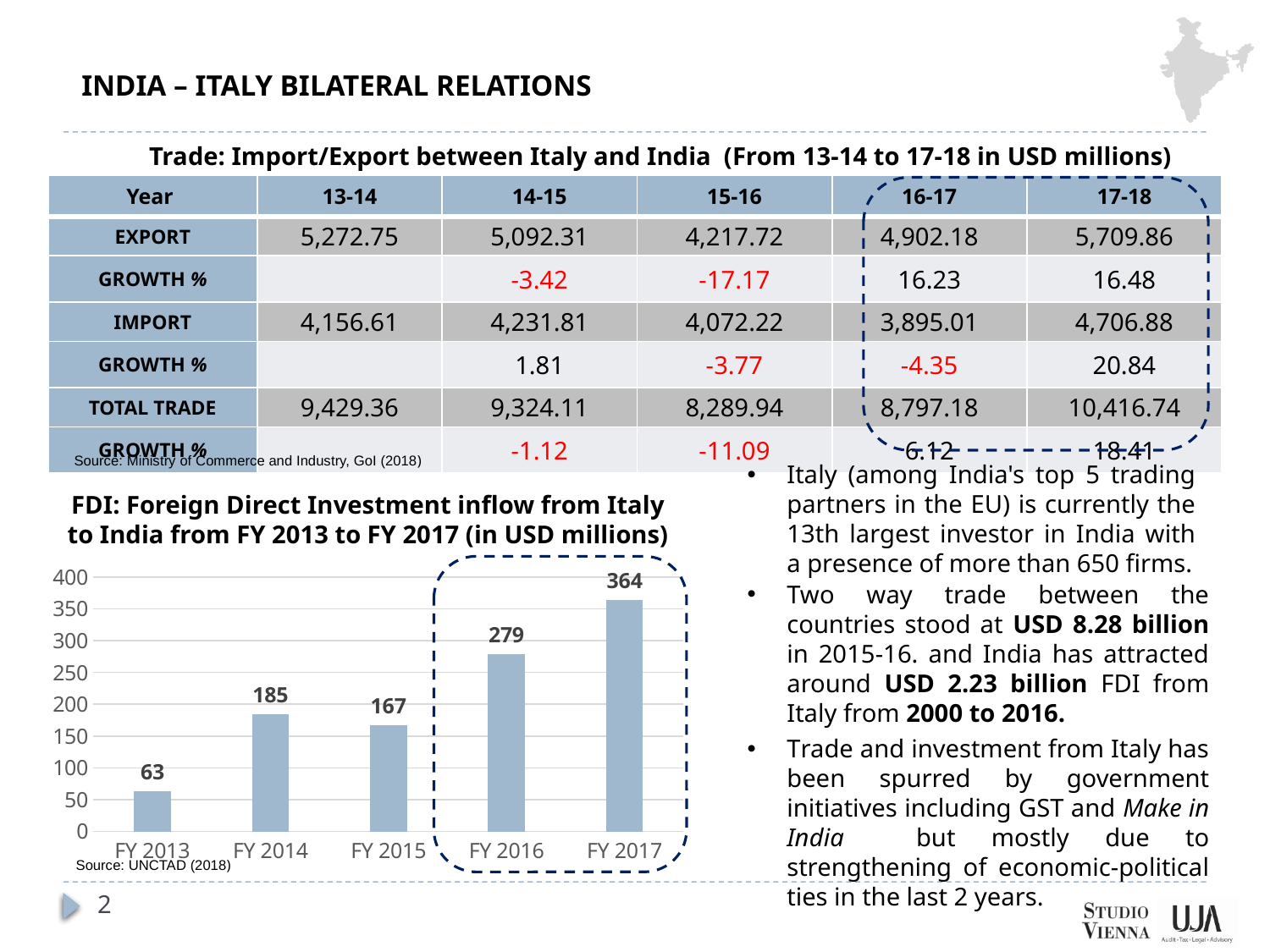
What kind of chart is used to show the FDI inflow from Italy to India? bar chart Is the FDI inflow value for FY 2017 greater or less than 350? greater What is the FDI inflow value for FY 2016 in the bar chart? 279 What is the difference between the FDI inflow in FY 2014 and FY 2015? 18 What is the FDI inflow value for FY 2013 in the bar chart? 63 What is the FDI inflow value for FY 2015 in the bar chart? 167 How many fiscal years are shown in the FDI bar chart? 5 What is the difference between the FDI inflow in FY 2017 and FY 2016? 85 Which fiscal year has the highest FDI inflow in the bar chart? FY 2017 What is the title of the bar chart on the slide? FDI: Foreign Direct Investment inflow from Italy to India from FY 2013 to FY 2017 (in USD millions) Which fiscal year has the lowest FDI inflow in the bar chart? FY 2013 Which is larger in the bar chart, the FDI inflow for FY 2014 or FY 2015? FY 2014